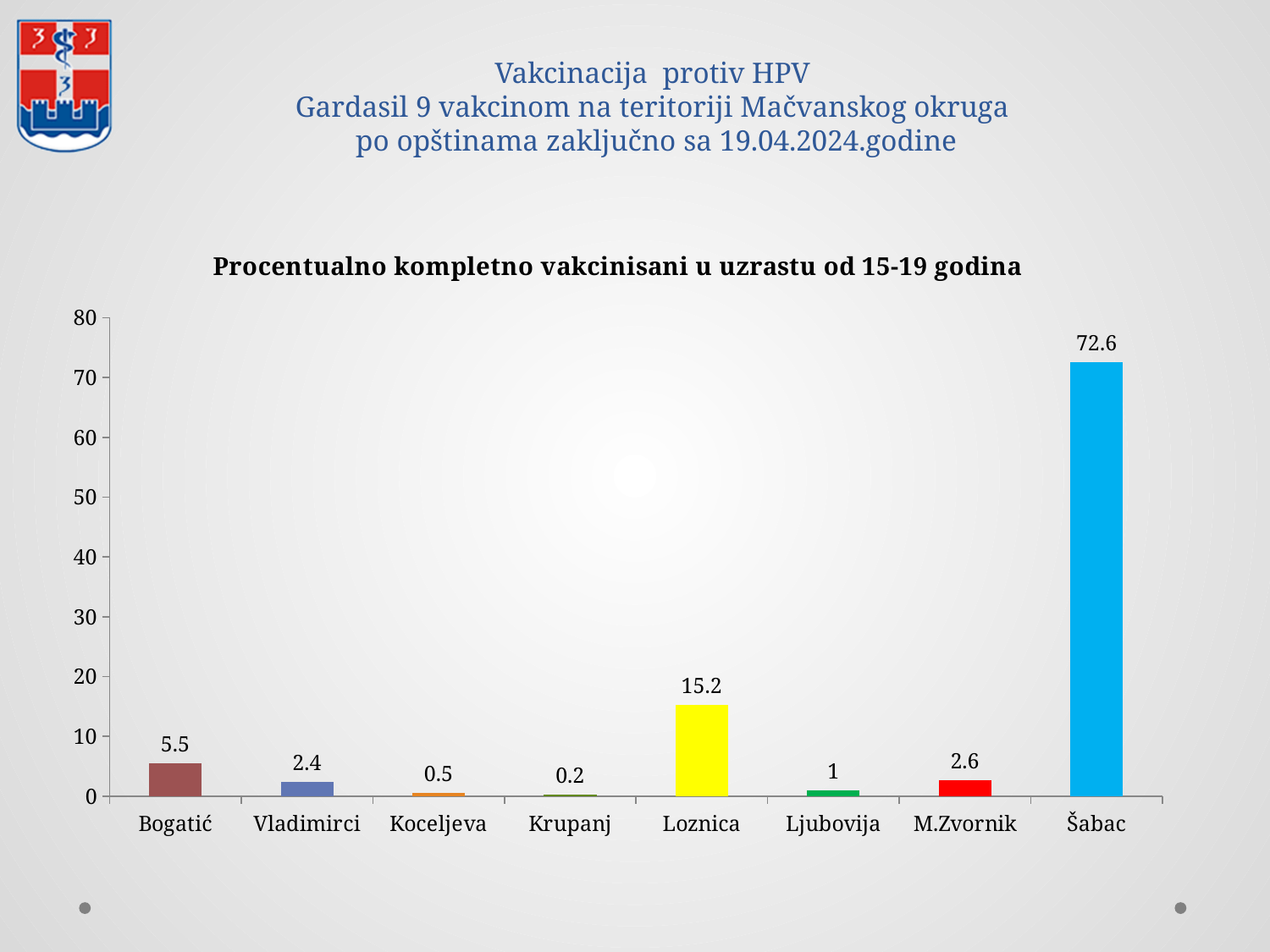
What is the value for Krupanj? 0.2 What is the title of the chart? Procentualno kompletno vakcinisani u uzrastu od 15-19 godina What is the value for Šabac? 72.6 What kind of chart is shown on the slide? bar chart What is the value for Loznica? 15.2 Which category has the highest value? Šabac Which is larger, the value for Bogatić or the value for M.Zvornik? Bogatić Which category has the lowest value? Krupanj What is the value for Bogatić? 5.5 What is the difference between the values for Šabac and Loznica? 57.4 Is the value for Loznica greater or less than 10? greater How many categories are shown on the x axis? 8